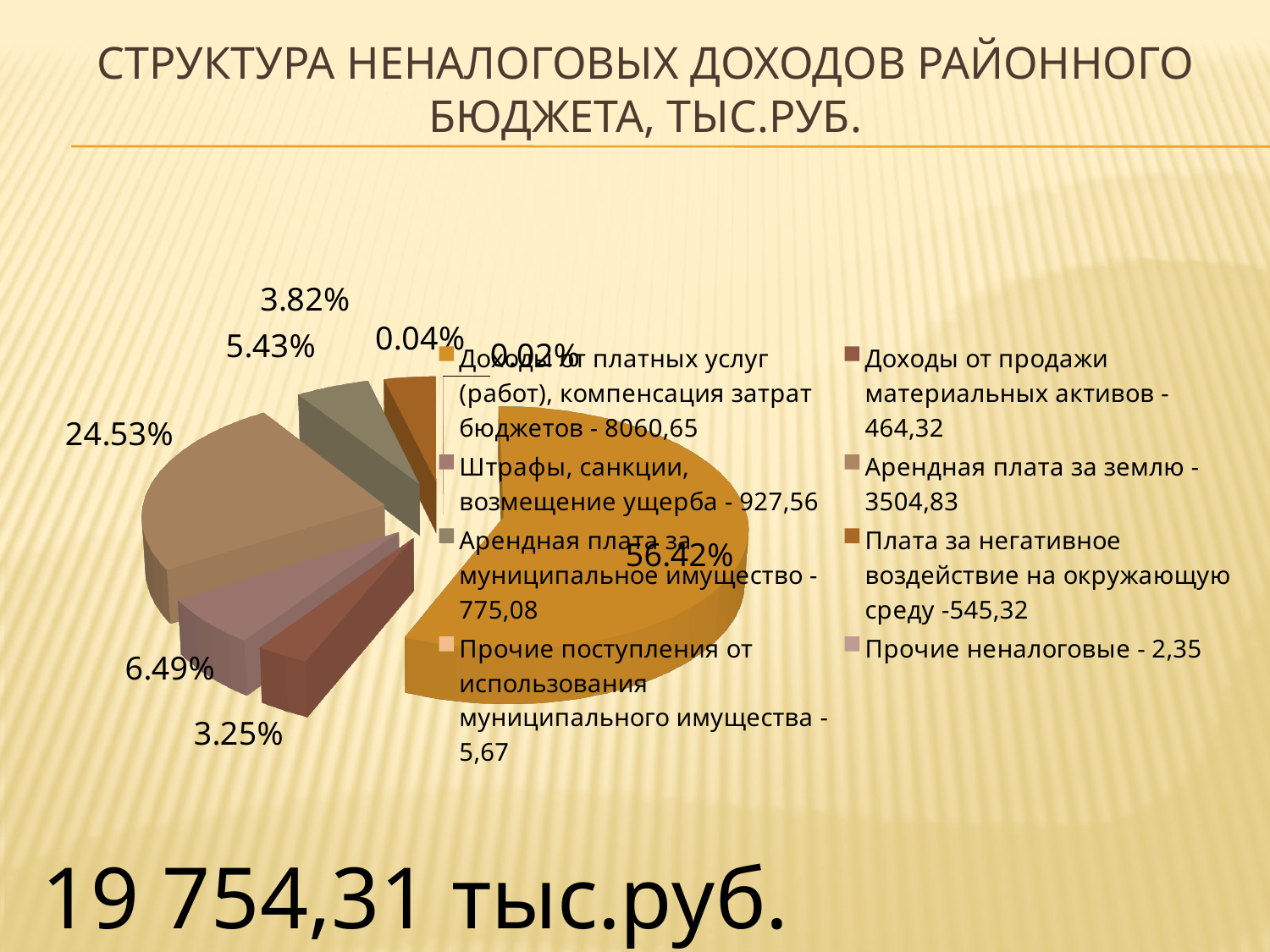
What value is given in the legend for Плата за негативное воздействие на окружающую среду? 545,32 What value is given in the legend for Арендная плата за землю? 3504,83 What is the difference between the legend values for Арендная плата за муниципальное имущество (775,08) and Плата за негативное воздействие на окружающую среду (545,32)? 229,76 What kind of chart is shown on the slide? pie chart What is the percentage shown for the smallest slice of the pie chart? 0.02% Which is larger according to the legend: Доходы от продажи материальных активов or Арендная плата за муниципальное имущество? Арендная плата за муниципальное имущество Which category has the smallest value according to the legend? Прочие неналоговые What value is given in the legend for Штрафы, санкции, возмещение ущерба? 927,56 How many categories does the legend of the pie chart list? 8 Which category has the largest value according to the legend? Доходы от платных услуг (работ), компенсация затрат бюджетов What is the percentage shown for the largest slice of the pie chart? 56.42% What total amount in тыс.руб. is printed at the bottom of the slide? 19 754,31 тыс.руб.